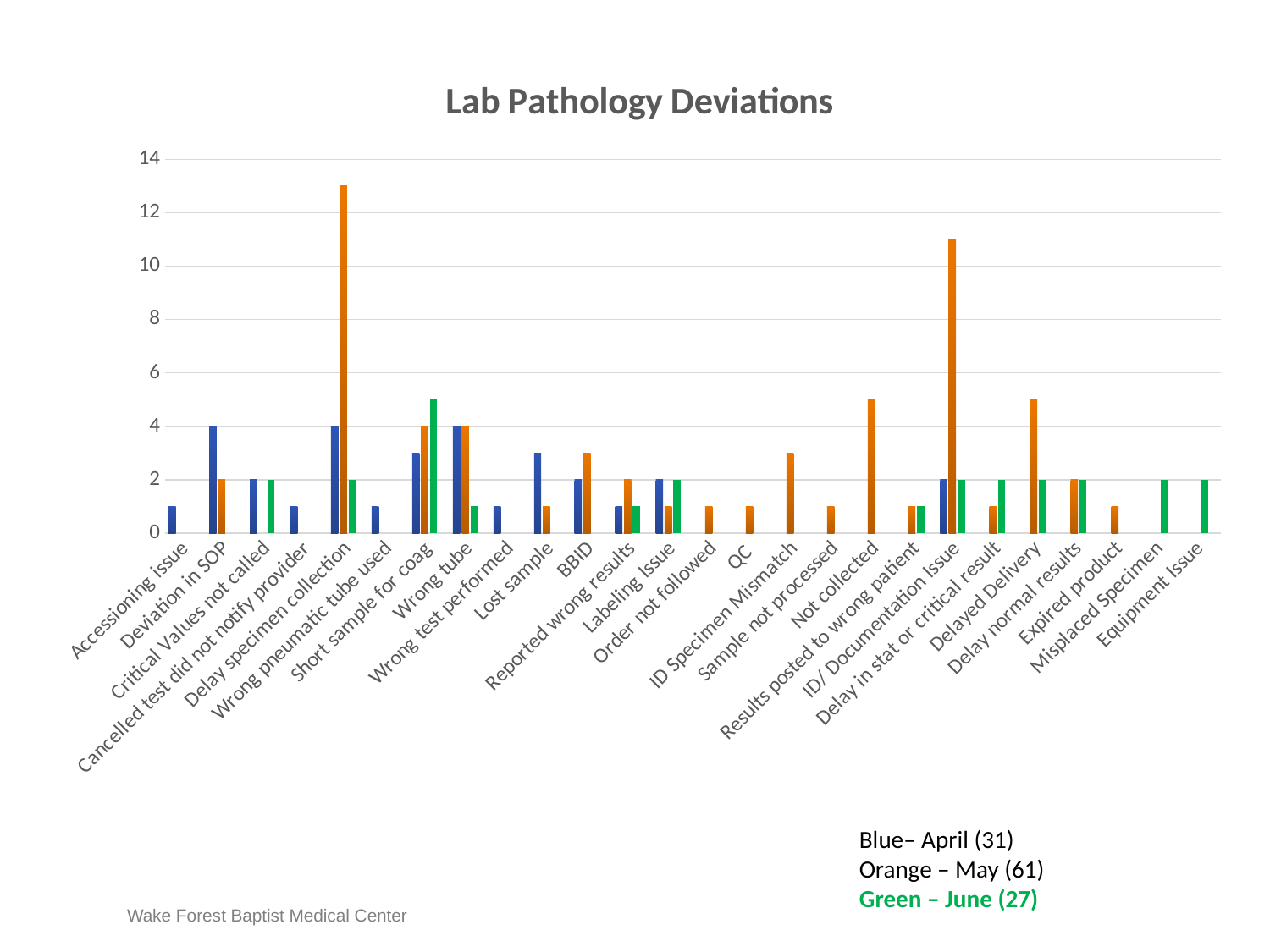
What is the June (green) value for Critical Values not called? 2 What is the difference between the April (blue) and June (green) values for Delay specimen collection? 2 Is the May (orange) value for Not collected greater or less than 4? greater What kind of chart is shown on the slide? bar chart How many series does the colour key below the chart list? 3 Is the May (orange) value for ID/ Documentation Issue greater or less than 10? greater Is the May (orange) value for Delay specimen collection greater or less than 12? greater For Short sample for coag, which month has the larger value, April (blue) or June (green)? June (green) What is the May (orange) value for Wrong tube? 4 What is the April (blue) value for Deviation in SOP? 4 Which category has the tallest bar in the chart? Delay specimen collection What is the title of the chart? Lab Pathology Deviations